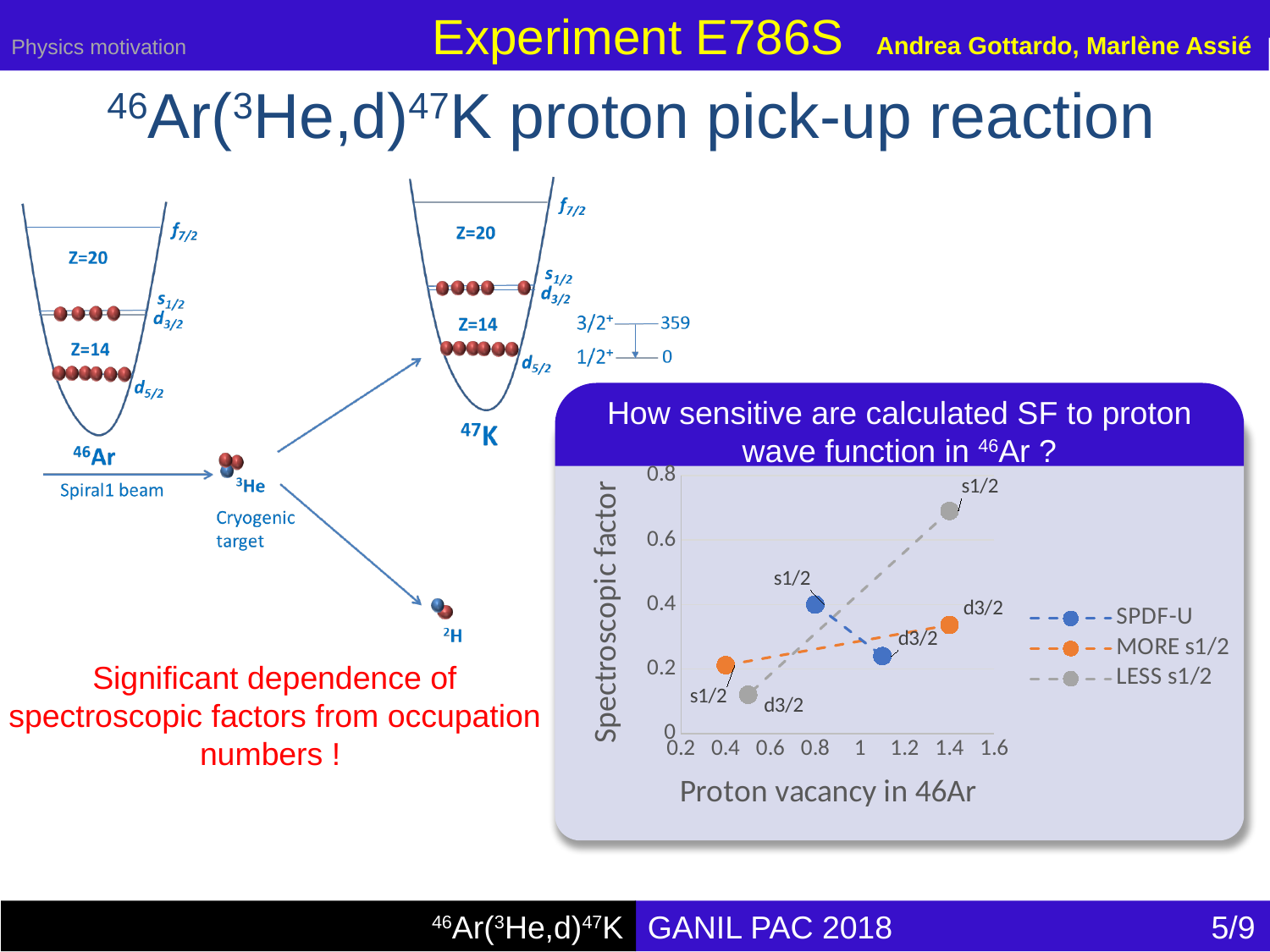
How many series does the chart legend list? 3 What is the label of the x axis of the chart? Proton vacancy in 46Ar Which series contains the point with the highest spectroscopic factor? LESS s1/2 Which series contains the point with the lowest spectroscopic factor? LESS s1/2 Is the spectroscopic factor of the s1/2 point of the LESS s1/2 series greater or less than 0.6? greater Is the spectroscopic factor of the s1/2 point of the SPDF-U series greater or less than 0.2? greater For the LESS s1/2 series, does the spectroscopic factor rise or fall as proton vacancy increases? rise For the SPDF-U series, which point has the larger spectroscopic factor, s1/2 or d3/2? s1/2 What kind of chart is shown on the slide? scatter chart Is the spectroscopic factor of the d3/2 point of the LESS s1/2 series greater or less than 0.2? less For the SPDF-U series, does the spectroscopic factor rise or fall as proton vacancy increases? fall What are the three series named in the chart legend? SPDF-U, MORE s1/2, LESS s1/2